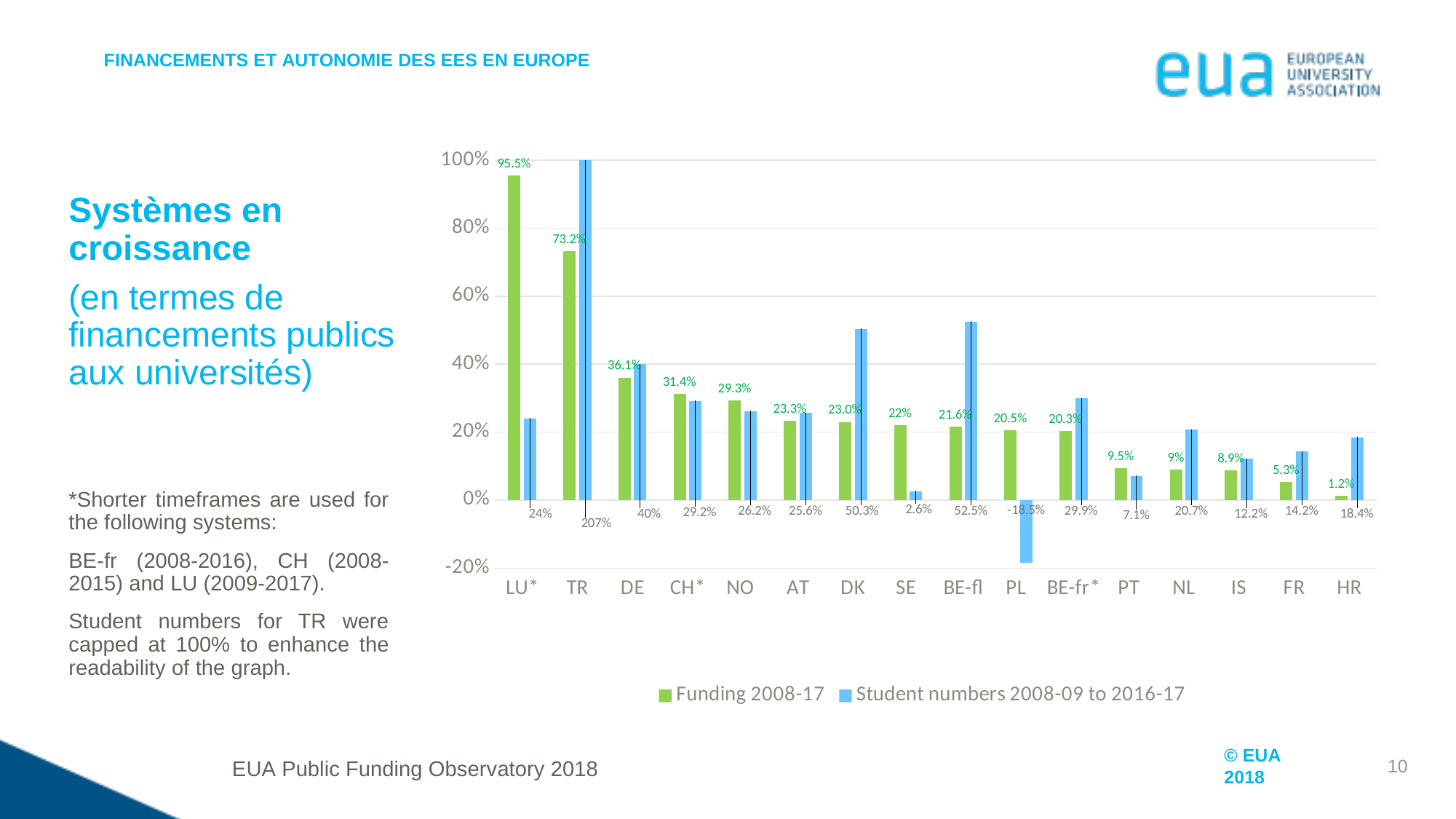
Which system has the lowest Funding 2008-17 value? HR Which series is shown in green according to the legend? Funding 2008-17 What is the difference between the Student numbers value and the Funding value for DE? 3.9 percentage points What is the Funding 2008-17 value for LU*? 95.5% How many series does the legend list? 2 What is the Student numbers 2008-09 to 2016-17 value for PL? -18.5% Which system has the lowest Student numbers 2008-09 to 2016-17 value? PL Which system has the highest Funding 2008-17 value? LU* What kind of chart is shown on the slide? Bar chart For DK, which is larger: Funding 2008-17 or Student numbers 2008-09 to 2016-17? Student numbers 2008-09 to 2016-17 What is the Student numbers 2008-09 to 2016-17 value for TR? 207% How many systems (categories) are shown on the x axis? 16